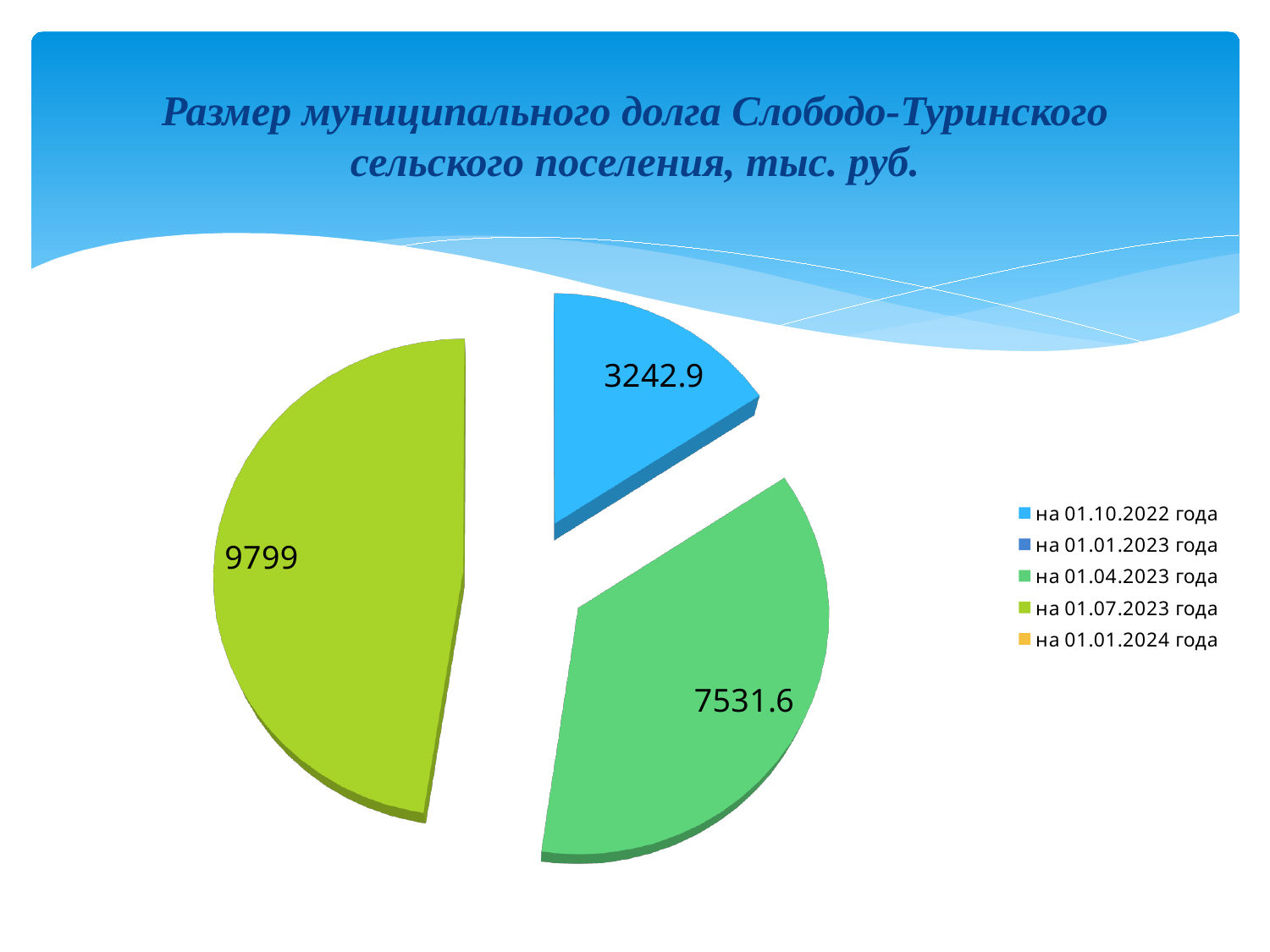
What is the difference between the values for "на 01.04.2023 года" and "на 01.10.2022 года"? 4288.7 Which of the three labelled slices is the smallest? на 01.10.2022 года What is the value of the slice for "на 01.04.2023 года"? 7531.6 How many slices with data labels are shown in the pie chart? 3 What is the difference between the values for "на 01.07.2023 года" and "на 01.04.2023 года"? 2267.4 What is the total of the three labelled slice values? 20573.5 How many entries does the legend list? 5 What is the value of the slice for "на 01.10.2022 года"? 3242.9 Which is larger: the value for "на 01.04.2023 года" or for "на 01.10.2022 года"? на 01.04.2023 года Which date has the largest slice in the pie chart? на 01.07.2023 года What is the value of the slice for "на 01.07.2023 года"? 9799 What type of chart is shown on the slide? Pie chart